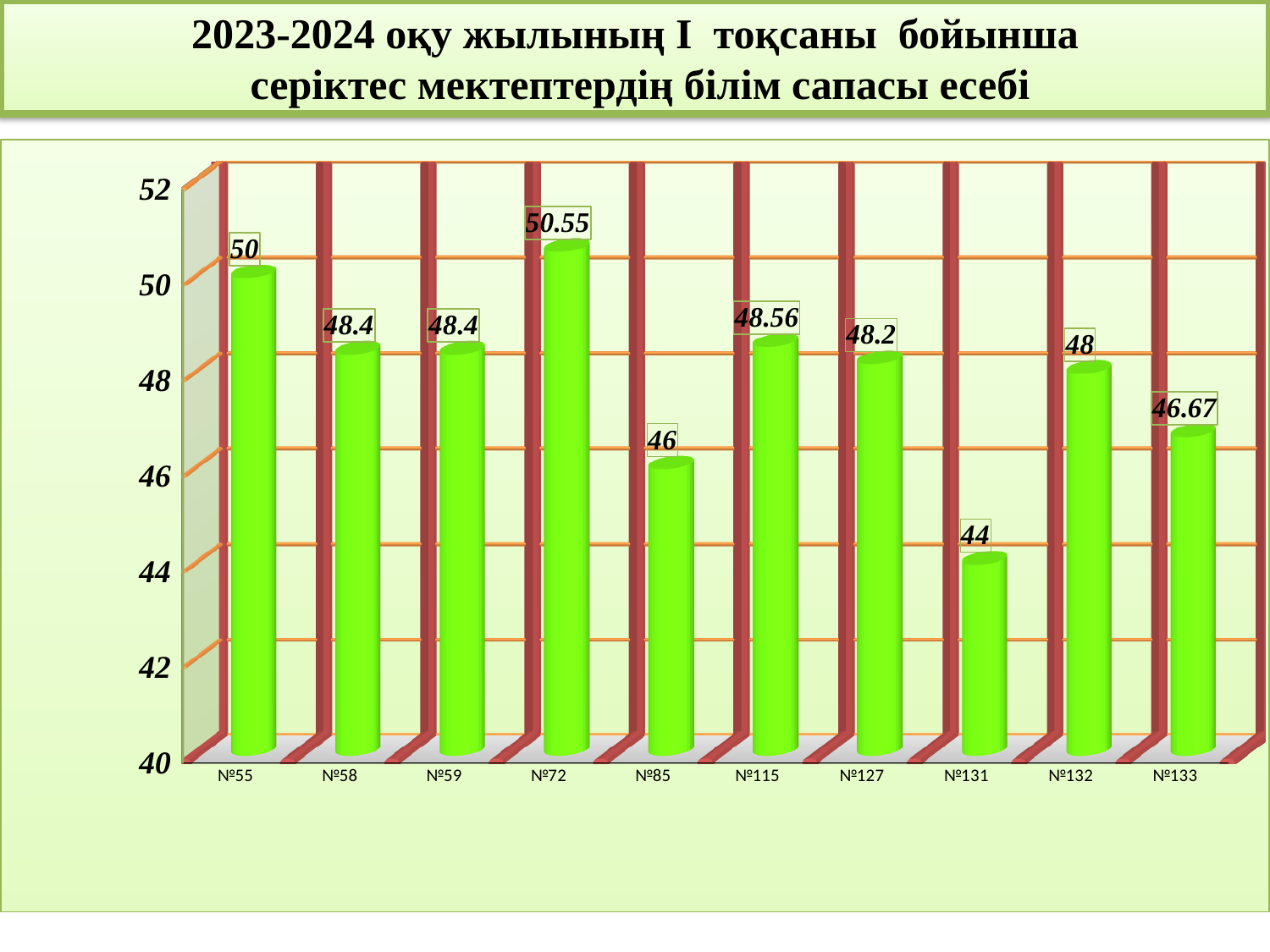
Which category has the lowest value? №131 What kind of chart is shown on the slide? bar chart What is the value for №115? 48.56 What is the difference between the values for №72 and №131? 6.55 What is the value for №72? 50.55 What is the value for №131? 44 How many categories are shown on the x axis? 10 What is the difference between the values for №55 and №85? 4 Is the value for №85 greater or less than 48? less Which is larger, the value for №127 or the value for №132? №127 Which category has the highest value? №72 What is the value for №133? 46.67